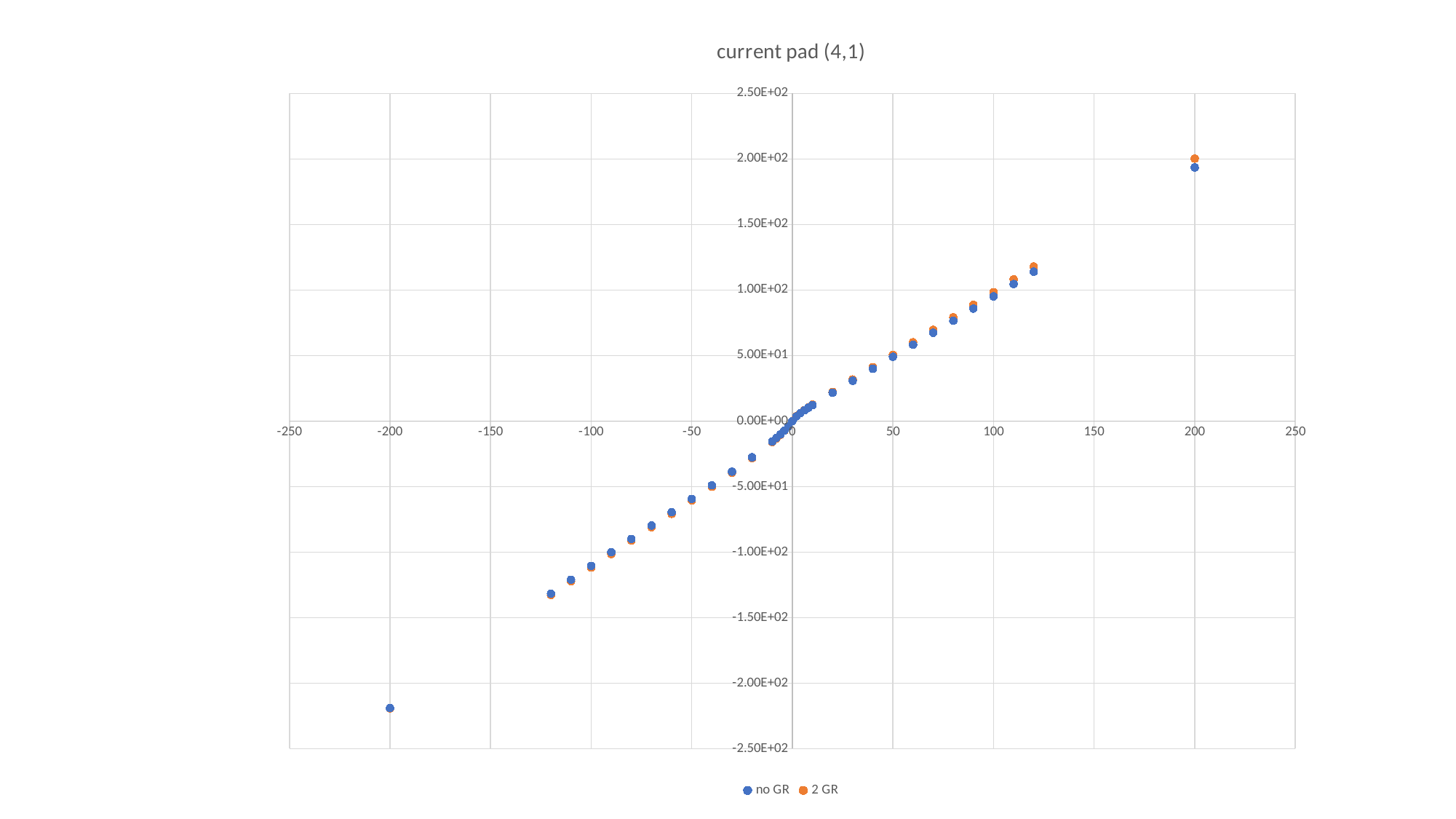
Do the plotted values rise or fall as the x value increases? rise Is the value for the 2 GR series at x = 80 greater or less than 5.00E+01? greater What is the title of the chart? current pad (4,1) How many series does the legend list? 2 Is the value for the no GR series at x = 120 greater or less than 1.00E+02? greater Is the value for the 2 GR series at x = 200 greater or less than 1.50E+02? greater What kind of chart is shown on the slide? scatter chart Which series is plotted in orange? 2 GR